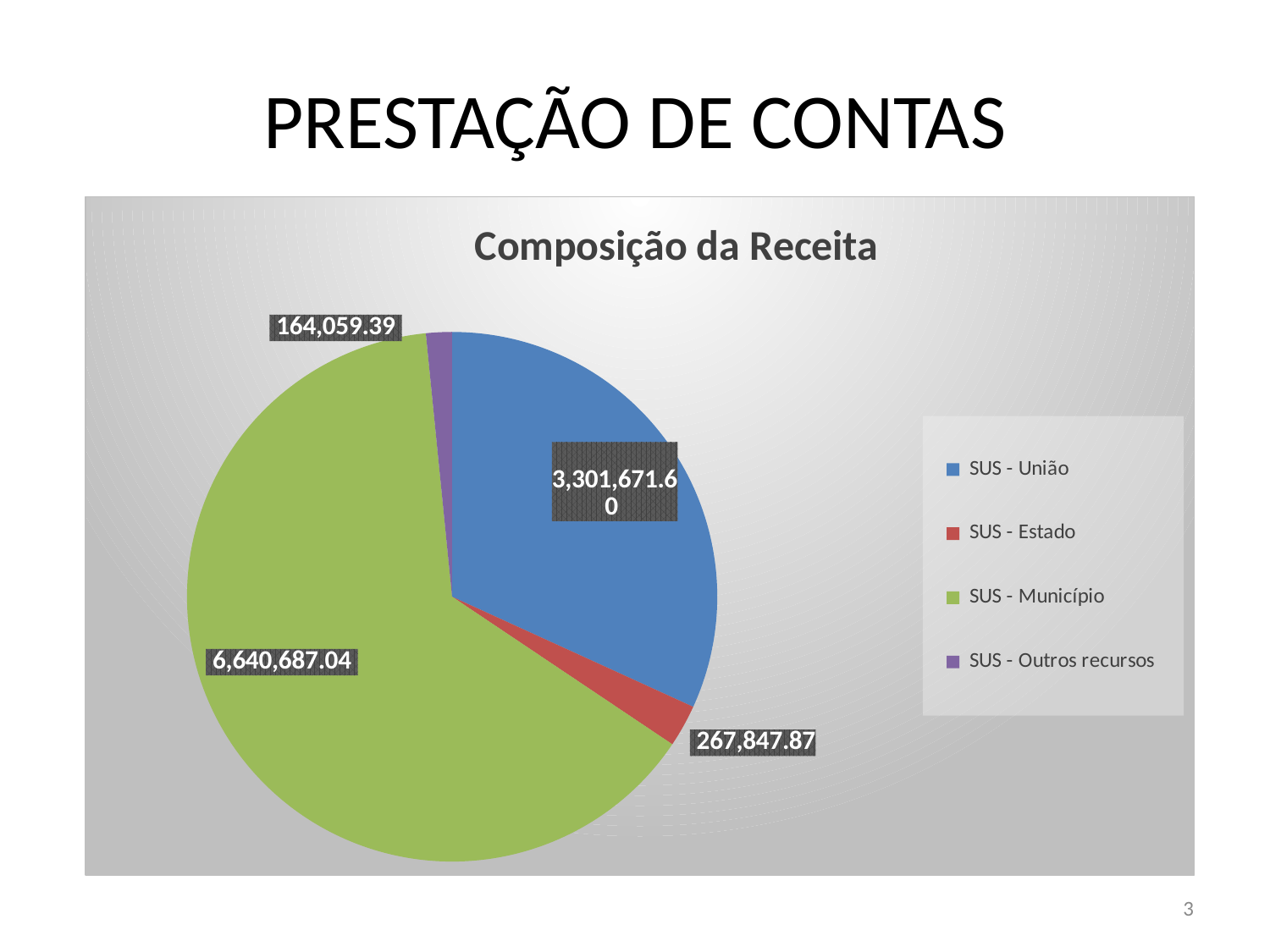
Which category has the smallest slice of the pie? SUS - Outros recursos What is the value for SUS - Estado? 267,847.87 What is the value for SUS - Outros recursos? 164,059.39 What type of chart is shown on the slide? Pie chart What is the title of the chart? Composição da Receita What is the value for SUS - União? 3,301,671.60 Which is larger, SUS - Estado or SUS - Outros recursos? SUS - Estado Which category has the largest slice of the pie? SUS - Município What colour is the slice for SUS - Outros recursos? Purple What is the difference between the values for SUS - Município and SUS - União? 3,339,015.44 How many categories does the legend list? 4 What is the value for SUS - Município? 6,640,687.04